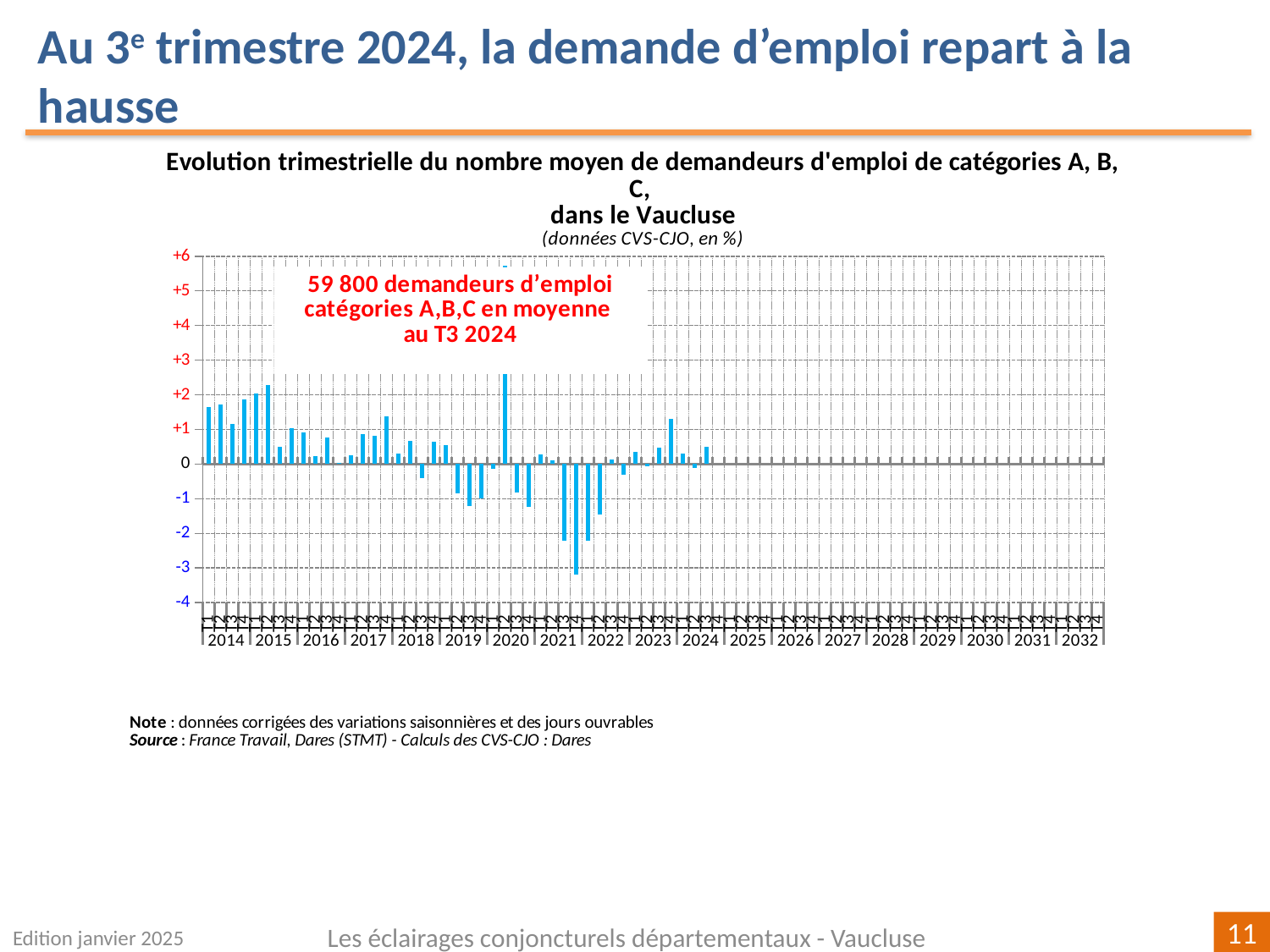
Which is lower, the value for T4 2021 or the value for T1 2022? T4 2021 Is the value for T1 2014 greater or less than +1? greater Which is larger, the value for T2 2015 or the value for T1 2014? T2 2015 What kind of chart is shown on the slide? bar chart Is the value for T4 2021 greater or less than -2? less How many years are labelled on the x axis? 19 Is the value for T2 2015 greater or less than +2? greater Which quarter has the lowest value on the chart? T4 2021 According to the annotation on the chart, how many demandeurs d'emploi catégories A, B, C were there on average in T3 2024? 59 800 Between T1 2014 and T2 2016, do the values generally rise or fall? fall